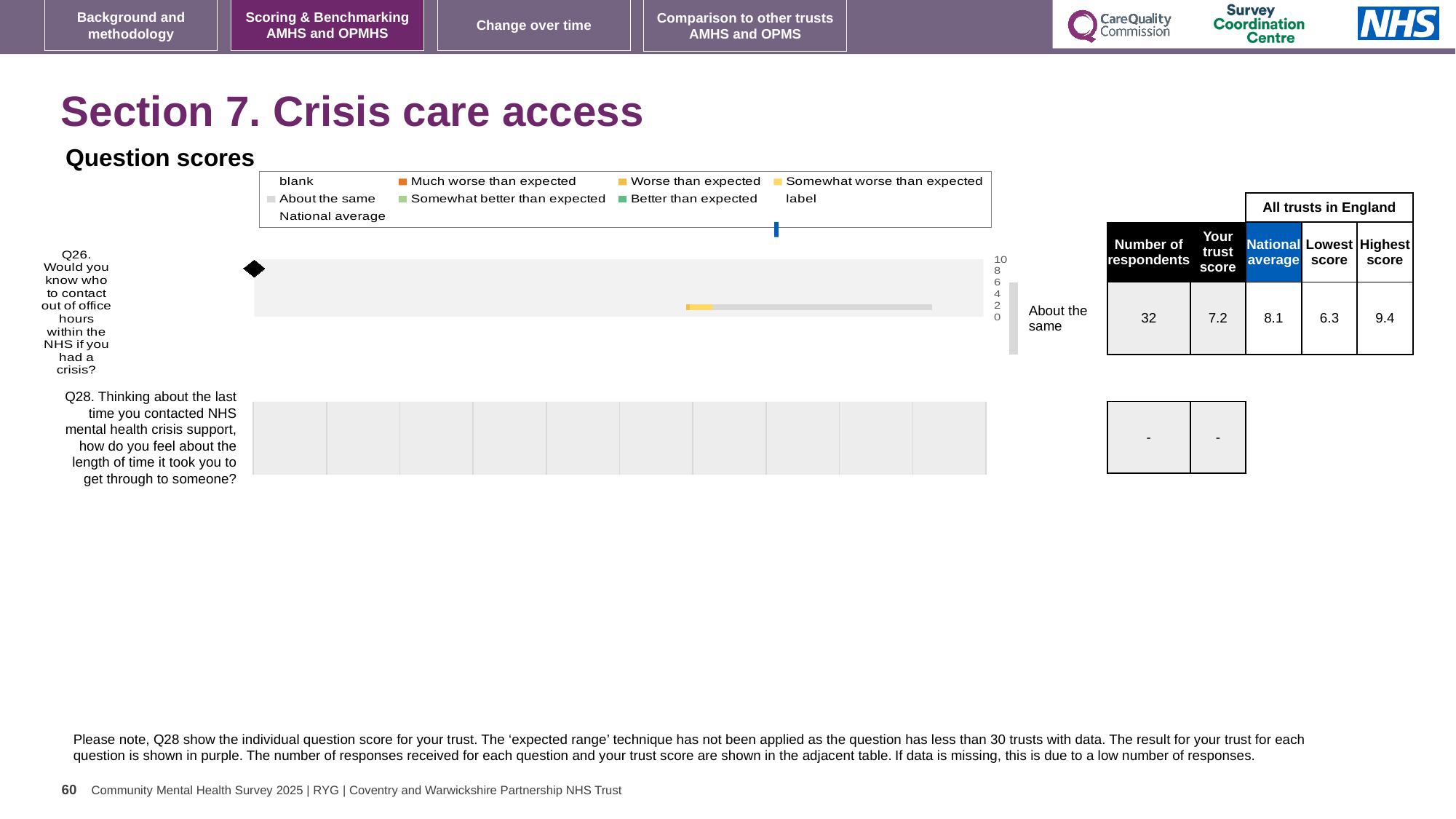
Which is larger for Q26, the trust score or the national average? National average How many respondents answered Q26? 32 What is the lowest score among all trusts in England for Q26? 6.3 What is the highest score among all trusts in England for Q26? 9.4 How many questions are plotted in the Question scores chart? 2 What is the trust score for Q26 (Would you know who to contact out of office hours within the NHS if you had a crisis)? 7.2 What is the maximum value shown on the score axis of the chart? 10 What type of chart is used to show the question scores? Bar chart What benchmark category is shown next to the Q26 bar? About the same What is the difference between the highest and lowest scores across all trusts in England for Q26? 3.1 What is the national average score for Q26? 8.1 What is the difference between the national average and the trust score for Q26? 0.9